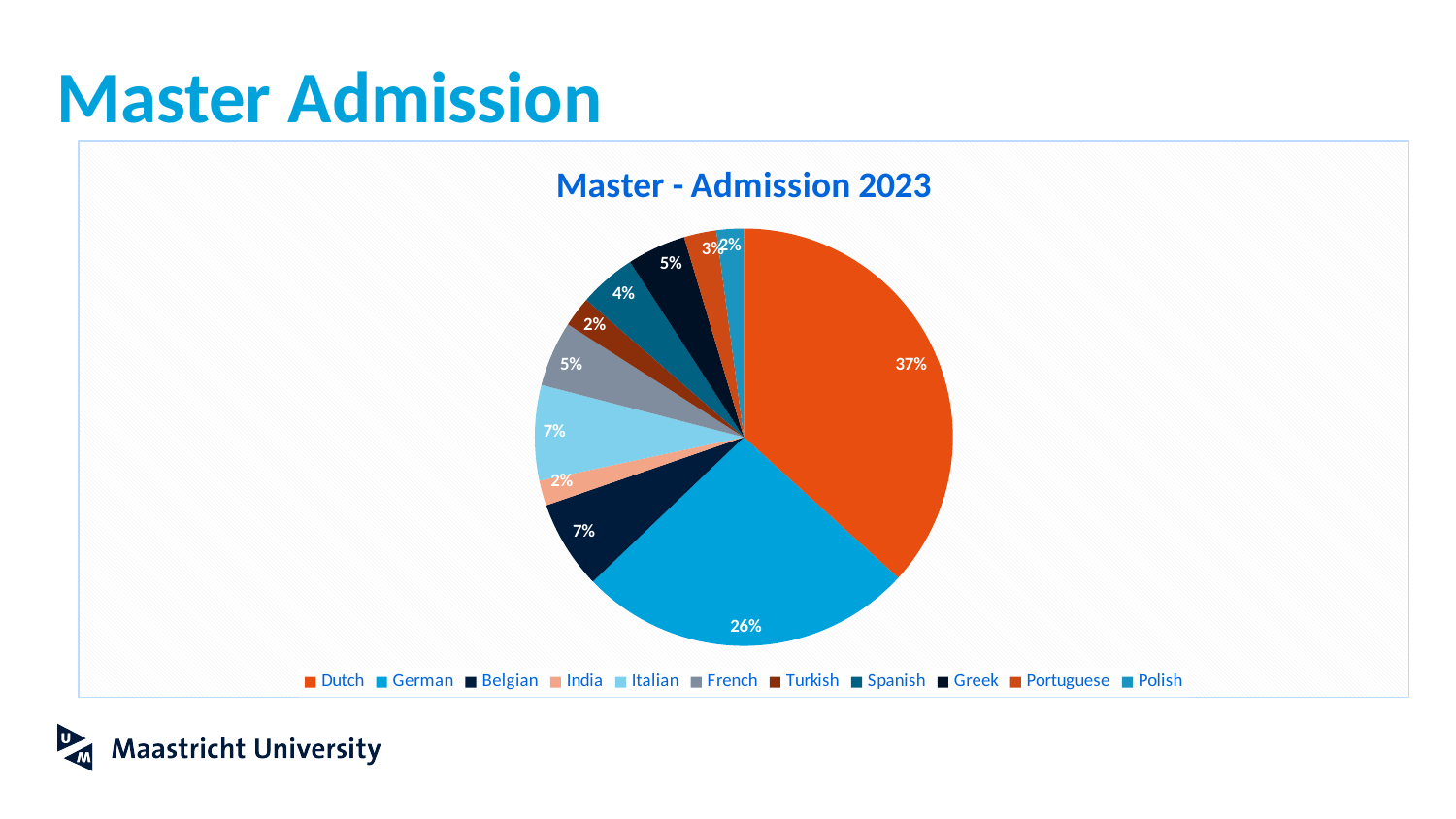
What is the difference in percentage points between the Dutch and German shares? 11 What percentage of the pie is Spanish? 4% What percentage of the pie is German? 26% What colour is the Dutch slice? orange What percentage of the pie is Italian? 7% What percentage of the pie is Dutch? 37% Which share is larger, French or Spanish? French What type of chart is shown on the slide? pie chart What is the title of the chart? Master - Admission 2023 What is the combined share of Dutch and German? 63% How many categories does the legend list? 11 Which category has the largest share of the pie? Dutch